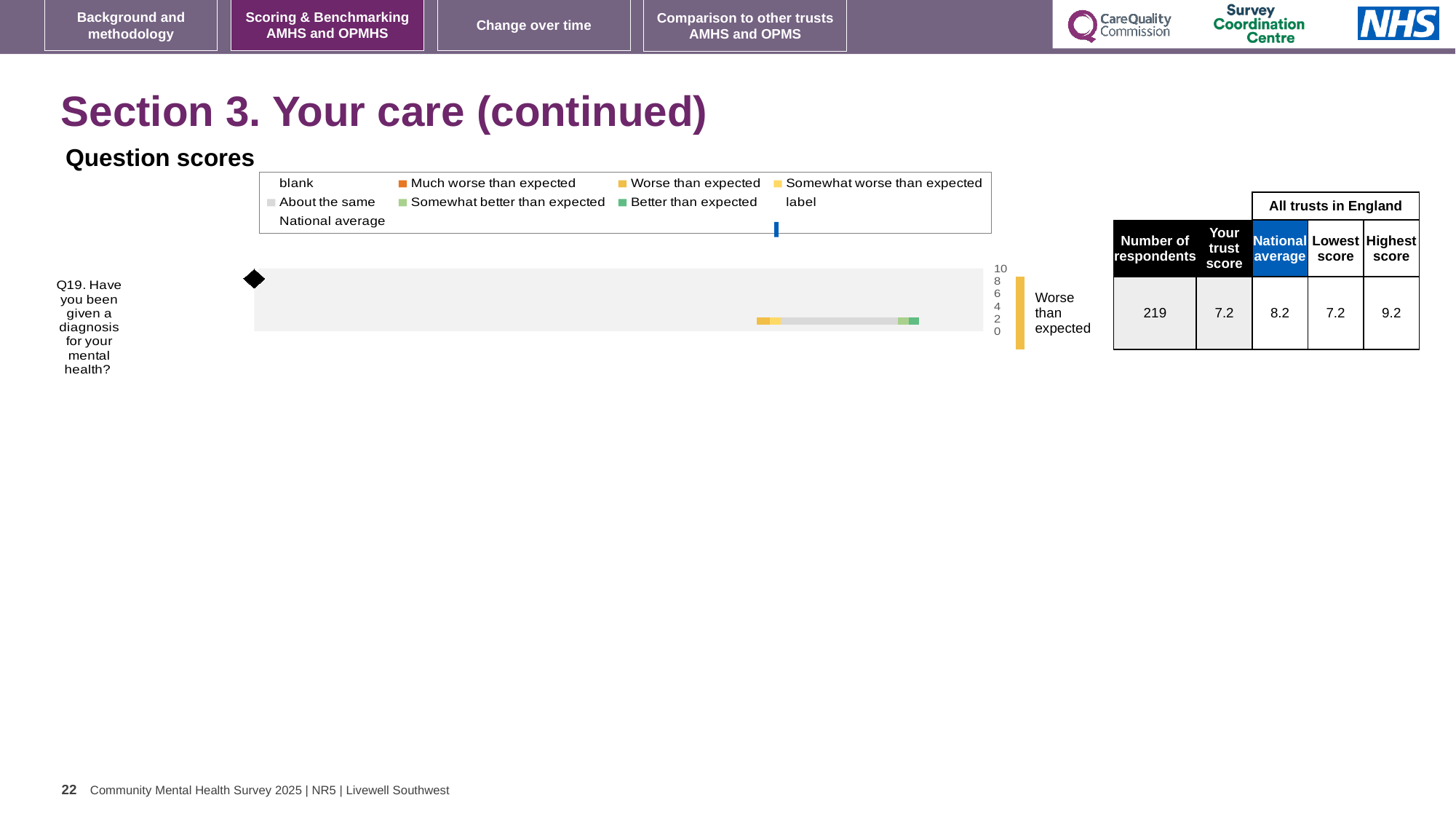
In the table next to the chart, what is the number of respondents for Q19? 219 What is the highest value shown on the chart's score axis? 10 How many survey questions are plotted in the chart? 1 In the table next to the chart, what is the lowest score among all trusts in England for Q19? 7.2 In the table next to the chart, what is the difference between the national average and your trust score for Q19? 1.0 In the table next to the chart, what is your trust score for Q19? 7.2 Which survey question is plotted in the chart? Q19. Have you been given a diagnosis for your mental health? What kind of chart is shown under the 'Question scores' heading? bar chart What rating label is shown to the right of the chart for Q19? Worse than expected In the table next to the chart, what is the national average for Q19? 8.2 In the table next to the chart, what is the highest score among all trusts in England for Q19? 9.2 In the table next to the chart, which is larger for Q19: your trust score or the national average? national average